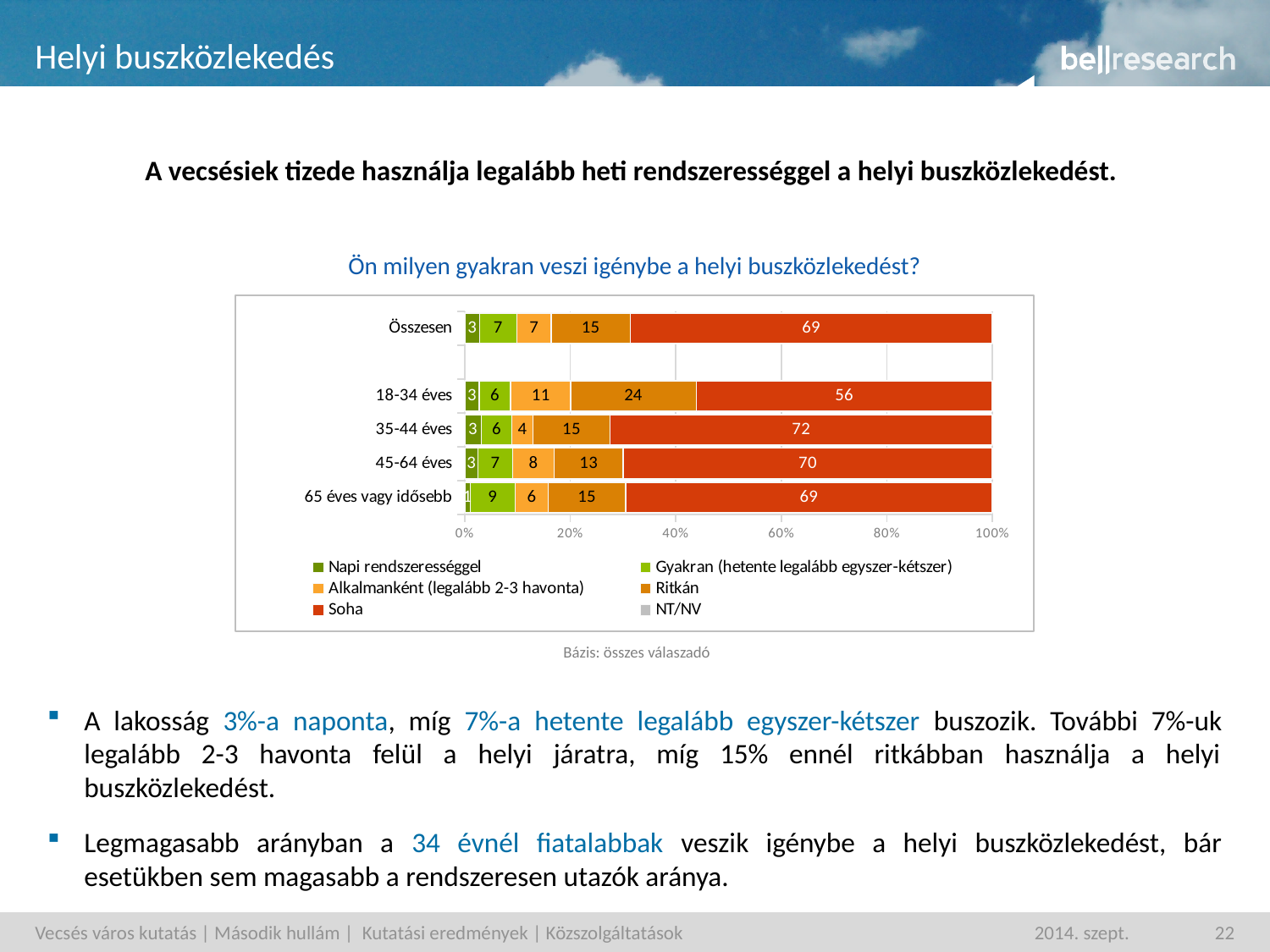
What is the 'Soha' value for the 18-34 éves group? 56 How many age-group categories (excluding Összesen) are plotted in the chart? 4 Which age group has the highest 'Soha' value? 35-44 éves How many series does the chart legend list? 6 Which is larger: the 'Ritkán' value for 18-34 éves or for 45-64 éves? 18-34 éves What is the 'Alkalmanként (legalább 2-3 havonta)' value for the Összesen row? 7 What is the 'Gyakran (hetente legalább egyszer-kétszer)' value for the 65 éves vagy idősebb group? 9 What is the title of the chart? Ön milyen gyakran veszi igénybe a helyi buszközlekedést? Which age group has the lowest 'Soha' value? 18-34 éves What type of chart is shown on the slide? stacked bar chart What is the 'Ritkán' value for the 18-34 éves group? 24 What is the difference between the 'Soha' values of the 35-44 éves and 18-34 éves groups? 16